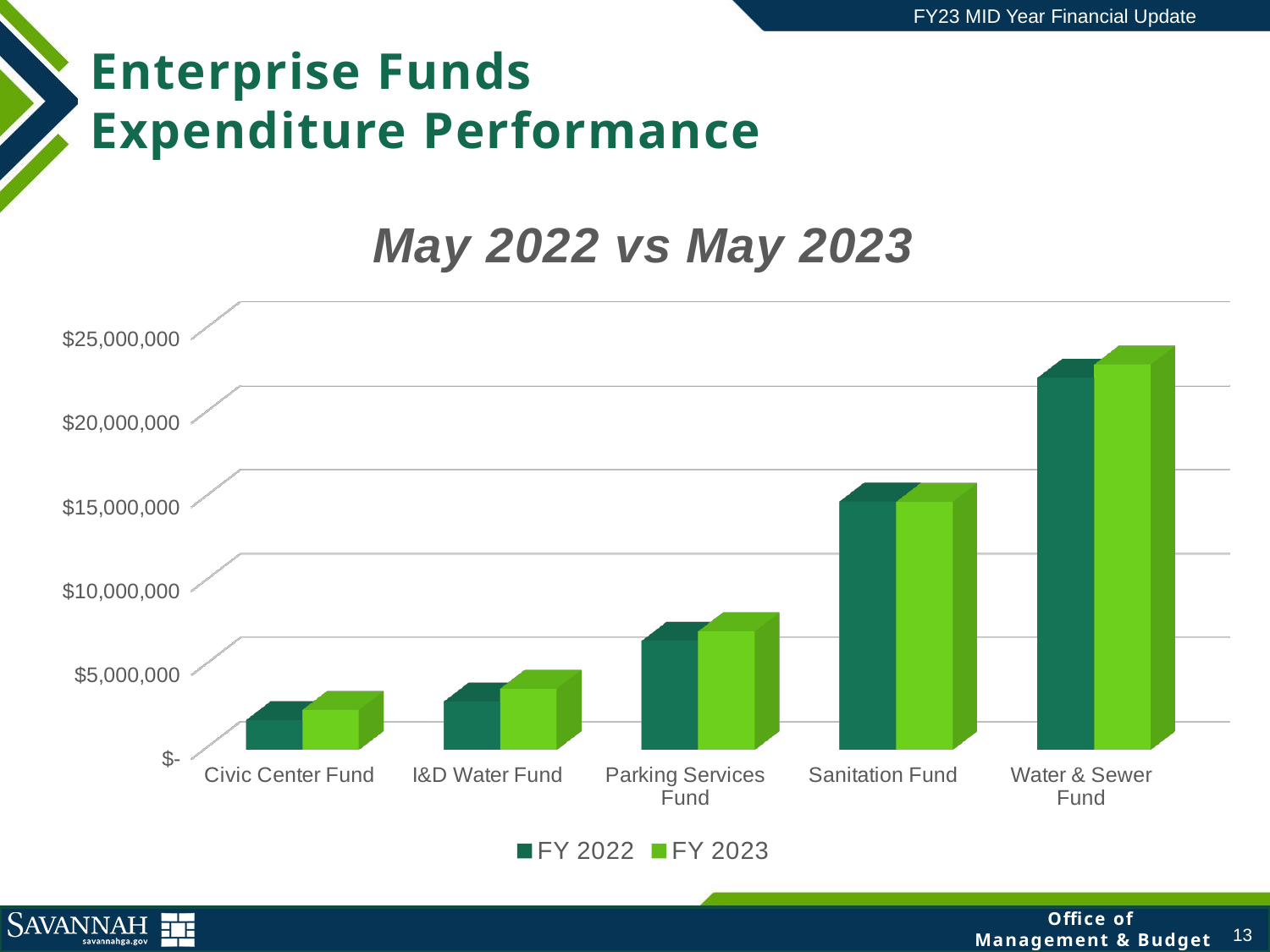
Is the FY 2023 value for Parking Services Fund greater or less than $5,000,000? greater How many funds (categories) are shown on the x axis of the chart? 5 How many series does the chart legend list? 2 Is the FY 2023 value for Civic Center Fund greater or less than $5,000,000? less What are the two series named in the chart legend? FY 2022 and FY 2023 What kind of chart is shown on the slide? bar chart Is the FY 2022 value for Water & Sewer Fund greater or less than $20,000,000? greater Which is larger, the FY 2023 value for Sanitation Fund or the FY 2023 value for Water & Sewer Fund? Water & Sewer Fund Which fund has the lowest expenditure in the chart? Civic Center Fund Which fund has the highest expenditure in the chart? Water & Sewer Fund Do the expenditure values generally rise or fall moving from left to right across the funds on the x axis? rise